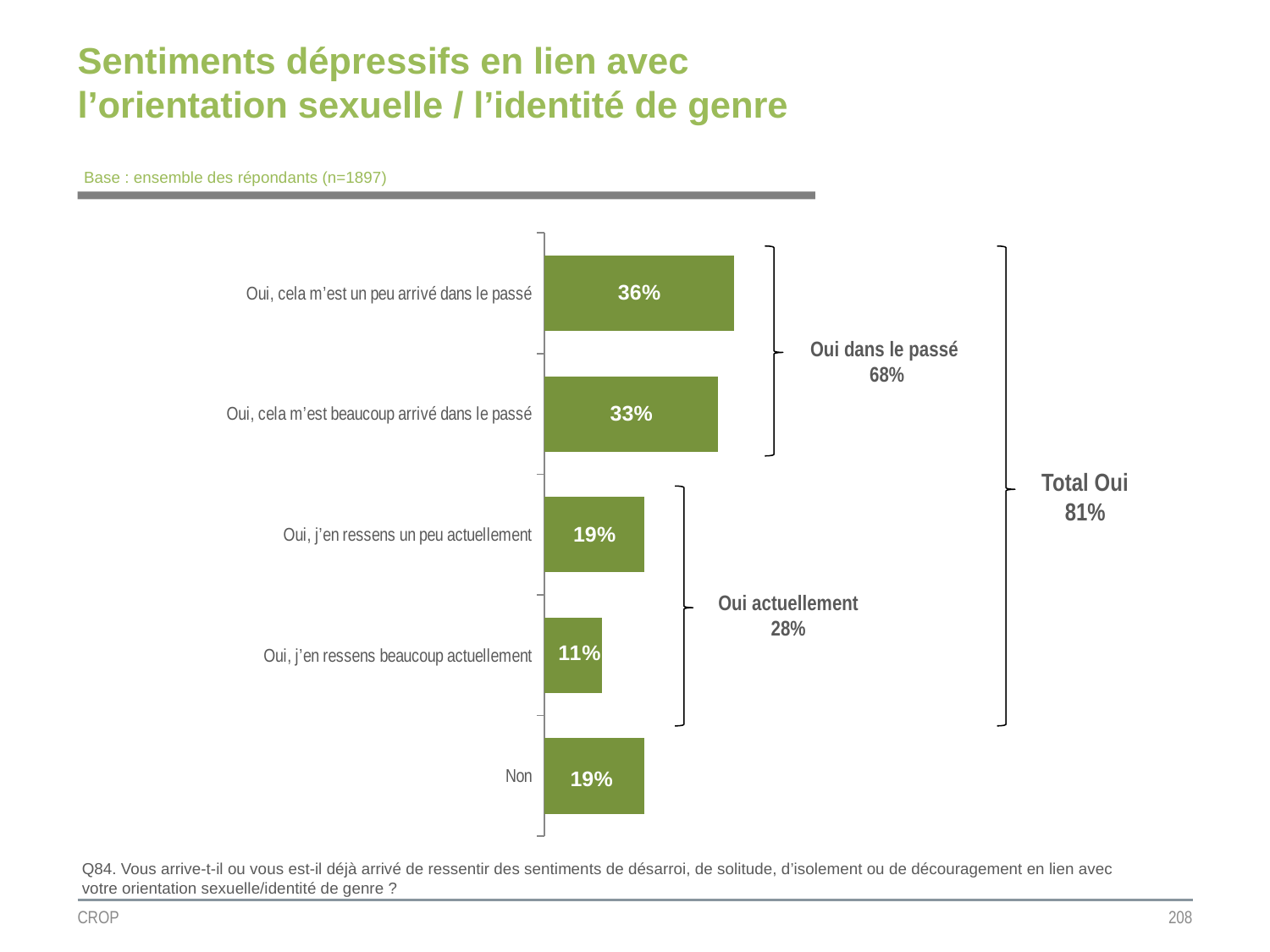
What is the combined value labelled "Oui dans le passé"? 68% Which category has the highest value? Oui, cela m’est un peu arrivé dans le passé What kind of chart is shown on the slide? Bar chart How many categories are shown in the chart? 5 Which is larger: "Oui, j’en ressens un peu actuellement" or "Oui, j’en ressens beaucoup actuellement"? Oui, j’en ressens un peu actuellement What is the value labelled "Total Oui"? 81% What is the value for "Non"? 19% Which category has the lowest value? Oui, j’en ressens beaucoup actuellement What is the value for "Oui, cela m’est un peu arrivé dans le passé"? 36% What is the value for "Oui, cela m’est beaucoup arrivé dans le passé"? 33% What is the value for "Oui, j’en ressens beaucoup actuellement"? 11% What is the difference between "Oui, cela m’est un peu arrivé dans le passé" and "Oui, cela m’est beaucoup arrivé dans le passé"? 3%